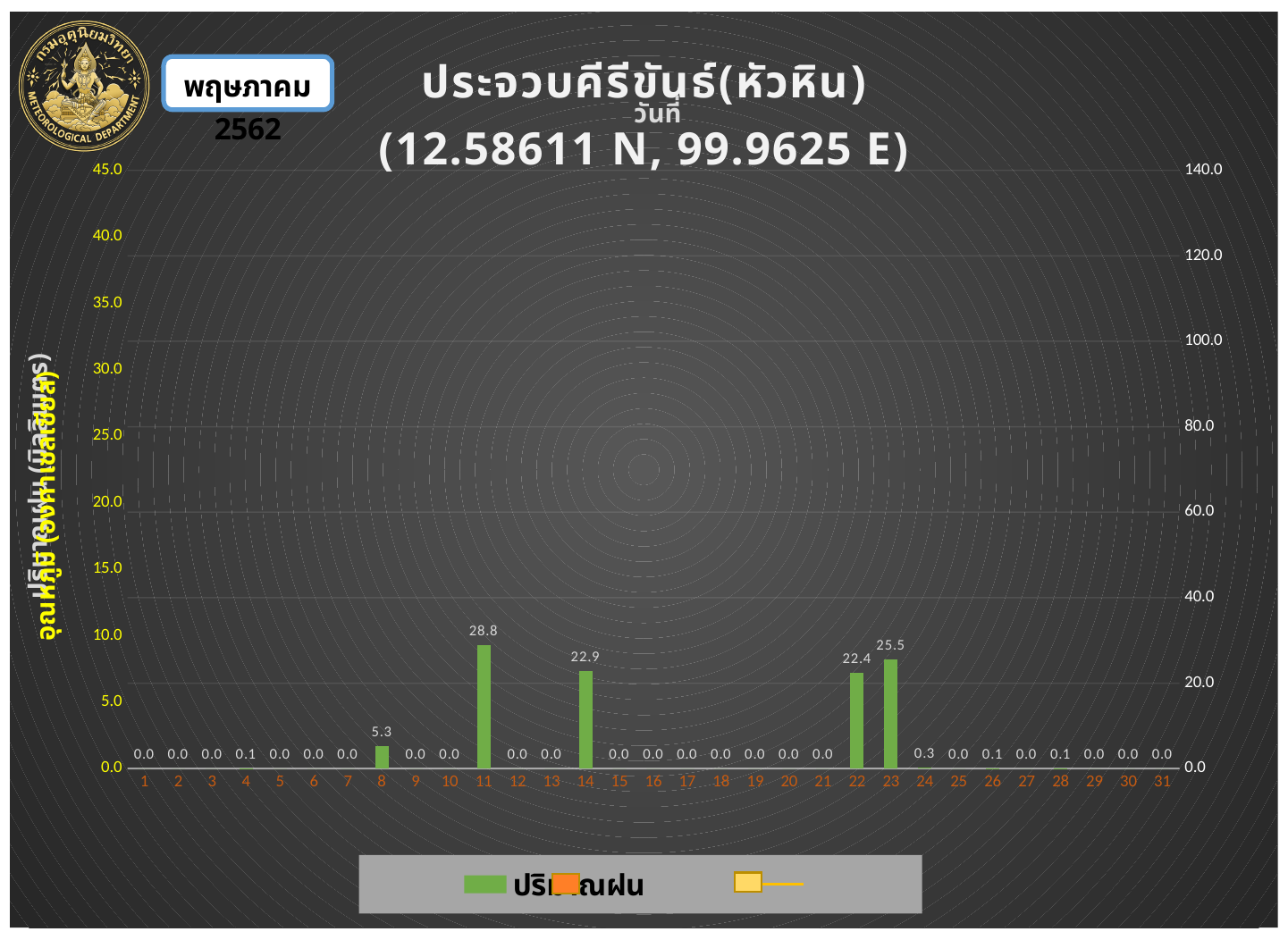
What is the rainfall value shown for day 8? 5.3 Which day has the highest rainfall value? 11 What is the difference between the rainfall values for day 11 and day 23? 3.3 What is the rainfall value shown for day 11? 28.8 How many days are shown on the x axis? 31 What is the rainfall value shown for day 24? 0.3 What is the difference between the rainfall values for day 14 and day 22? 0.5 What kind of chart is shown on the slide? bar chart What is the rainfall value shown for day 23? 25.5 Which has a larger rainfall value, day 8 or day 22? day 22 Which has a larger rainfall value, day 14 or day 23? day 23 What colour are the rainfall bars in the chart? green